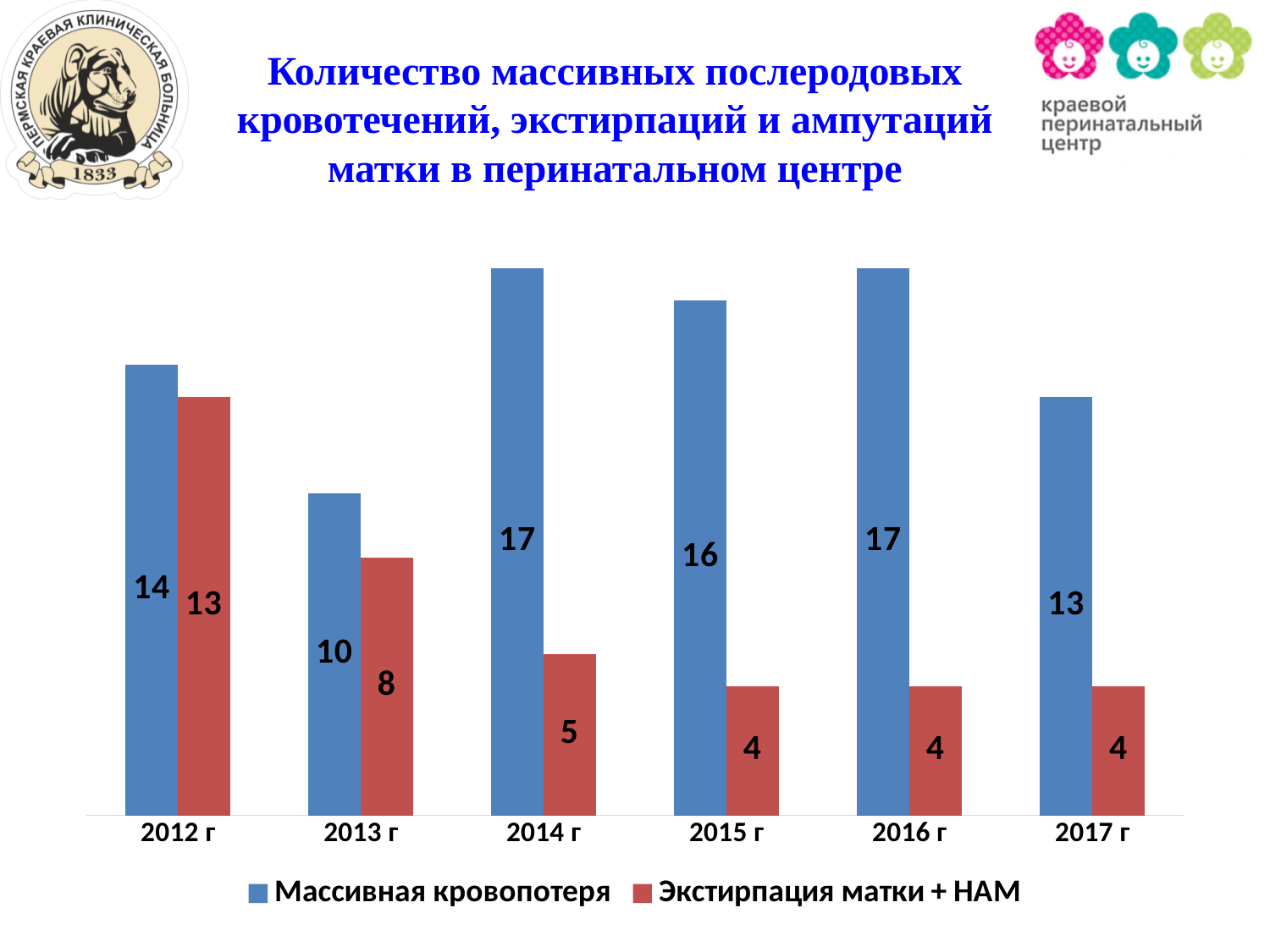
Which year has the lowest value for Массивная кровопотеря? 2013 г Which is larger in 2012 г: Массивная кровопотеря or Экстирпация матки + НАМ? Массивная кровопотеря Does the value for Экстирпация матки + НАМ rise or fall from 2012 г to 2015 г? fall What is the difference between Массивная кровопотеря and Экстирпация матки + НАМ in 2016 г? 13 How many series does the legend list? 2 What colour are the bars for Экстирпация матки + НАМ? red What is the value for Массивная кровопотеря in 2014 г? 17 What kind of chart is shown on the slide? bar chart How many years are shown on the x axis? 6 What is the value for Массивная кровопотеря in 2017 г? 13 Which year has the highest value for Экстирпация матки + НАМ? 2012 г What is the value for Экстирпация матки + НАМ in 2013 г? 8